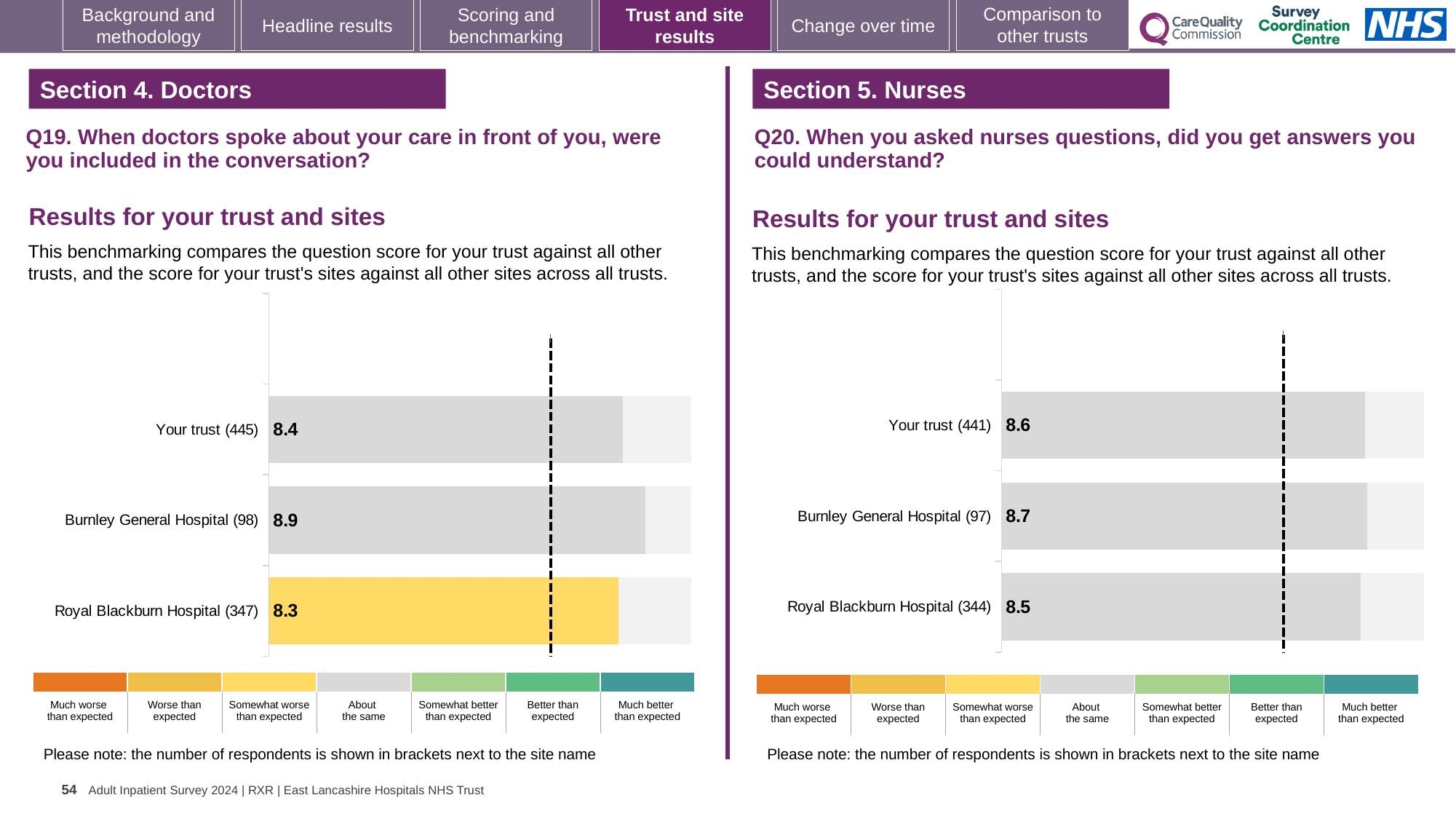
What type of chart is used on the slide? Bar chart In the Q20 chart (right), what is the score for Your trust? 8.6 In the Q19 chart (left), which bar is coloured yellow? Royal Blackburn Hospital In the Q19 chart (left), what is the difference between the scores for Burnley General Hospital and Royal Blackburn Hospital? 0.6 In the Q20 chart (right), what is the score for Royal Blackburn Hospital? 8.5 In the Q20 chart (right), what is the difference between the scores for Burnley General Hospital and Your trust? 0.1 In the Q19 chart (left), which site or trust has the highest score? Burnley General Hospital In the Q19 chart (left), what is the score for Burnley General Hospital? 8.9 In the Q19 chart (left), how many bars are plotted? 3 In the Q19 chart (left), what is the score for Your trust? 8.4 In the Q19 chart (left), what is the score for Royal Blackburn Hospital? 8.3 In the Q20 chart (right), which site or trust has the lowest score? Royal Blackburn Hospital